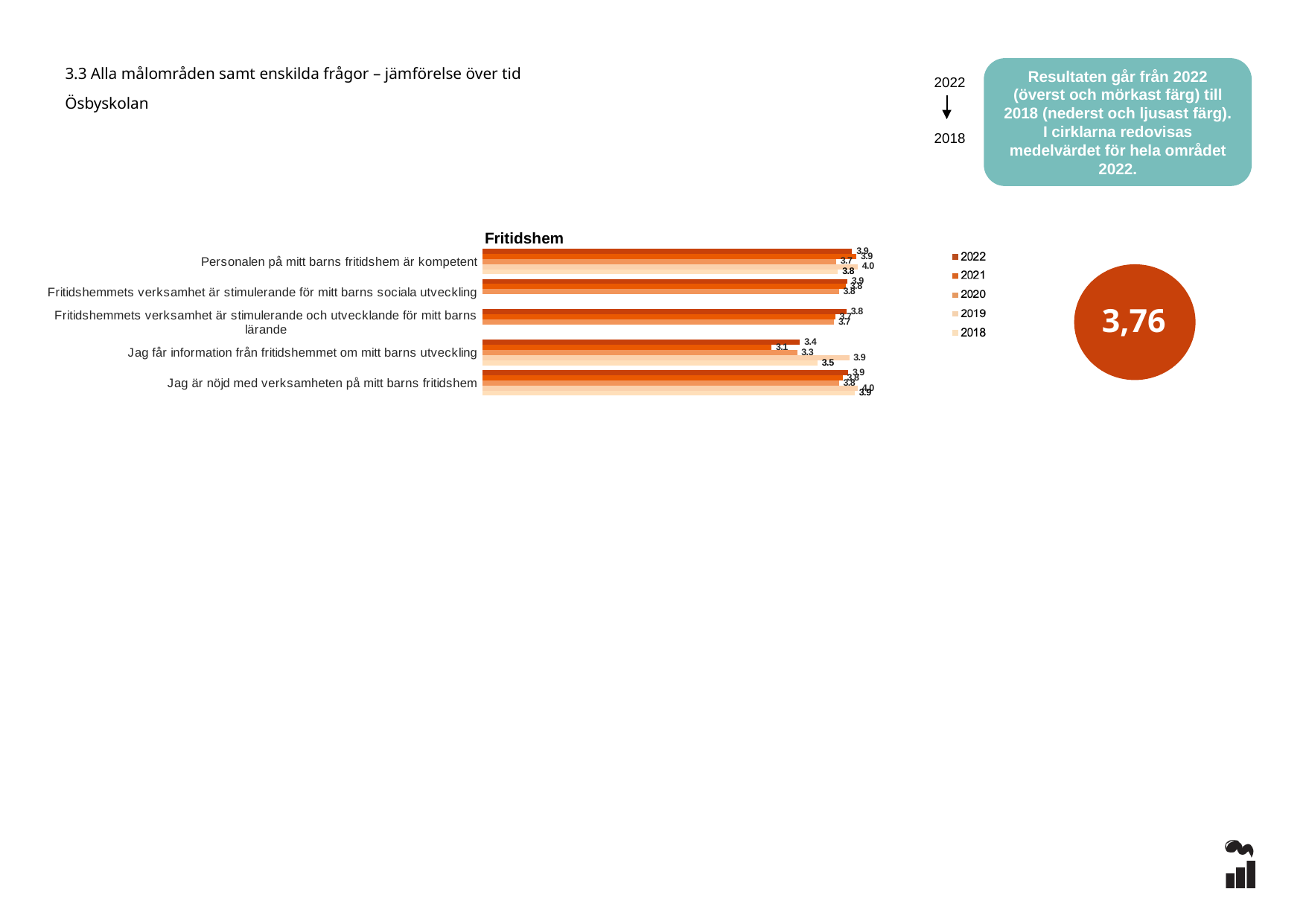
How many series does the legend of the "Fritidshem" chart list? 5 What is the difference between the 2022 and 2021 values for "Jag får information från fritidshemmet om mitt barns utveckling"? 0.3 For "Jag får information från fritidshemmet om mitt barns utveckling", which year has the lowest value? 2021 What is the 2019 value for "Jag får information från fritidshemmet om mitt barns utveckling"? 3.9 What kind of chart is the "Fritidshem" chart? bar chart What is the 2021 value for "Jag får information från fritidshemmet om mitt barns utveckling"? 3.1 What is the mean value for the whole area in 2022 shown in the circle next to the "Fritidshem" chart? 3,76 How many categories (questions) are shown on the "Fritidshem" chart? 5 Which category has the lowest 2022 value on the "Fritidshem" chart? Jag får information från fritidshemmet om mitt barns utveckling What is the 2022 value for "Jag får information från fritidshemmet om mitt barns utveckling"? 3.4 For "Jag får information från fritidshemmet om mitt barns utveckling", which is larger: the 2022 value or the 2021 value? 2022 Which years are listed in the legend of the "Fritidshem" chart? 2022, 2021, 2020, 2019, 2018